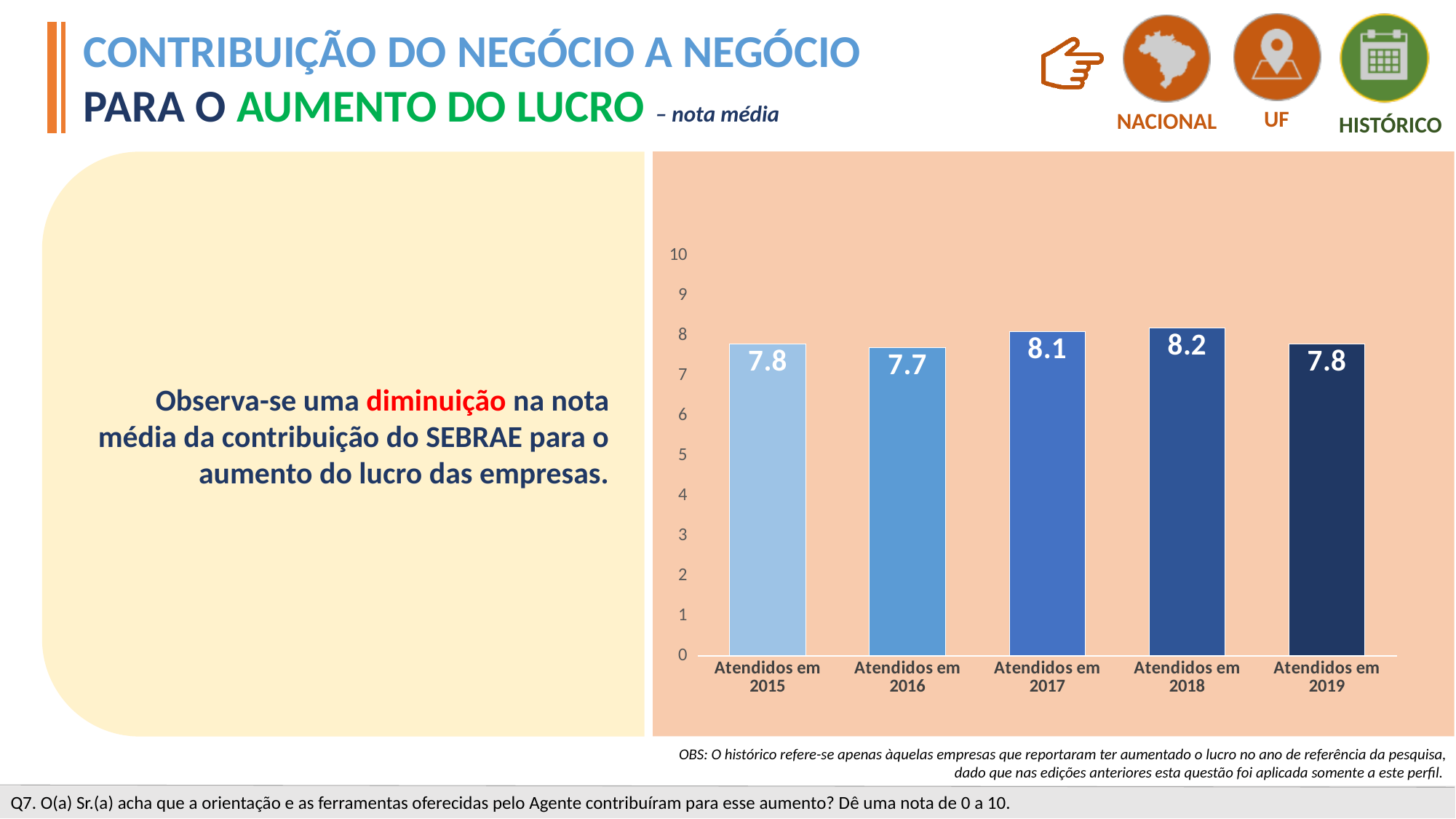
What is the value for Atendidos em 2015? 7.8 What kind of chart is shown on the slide? bar chart What is the difference between the values for Atendidos em 2018 and Atendidos em 2016? 0.5 How many categories are shown on the x axis? 5 What is the value for Atendidos em 2018? 8.2 Which category has the lowest value? Atendidos em 2016 Which category has the highest value? Atendidos em 2018 Do the values rise or fall from Atendidos em 2018 to Atendidos em 2019? fall What is the difference between the values for Atendidos em 2017 and Atendidos em 2019? 0.3 Which is larger, the value for Atendidos em 2017 or Atendidos em 2016? Atendidos em 2017 What is the value for Atendidos em 2019? 7.8 Is the value for Atendidos em 2018 greater or less than 8? greater